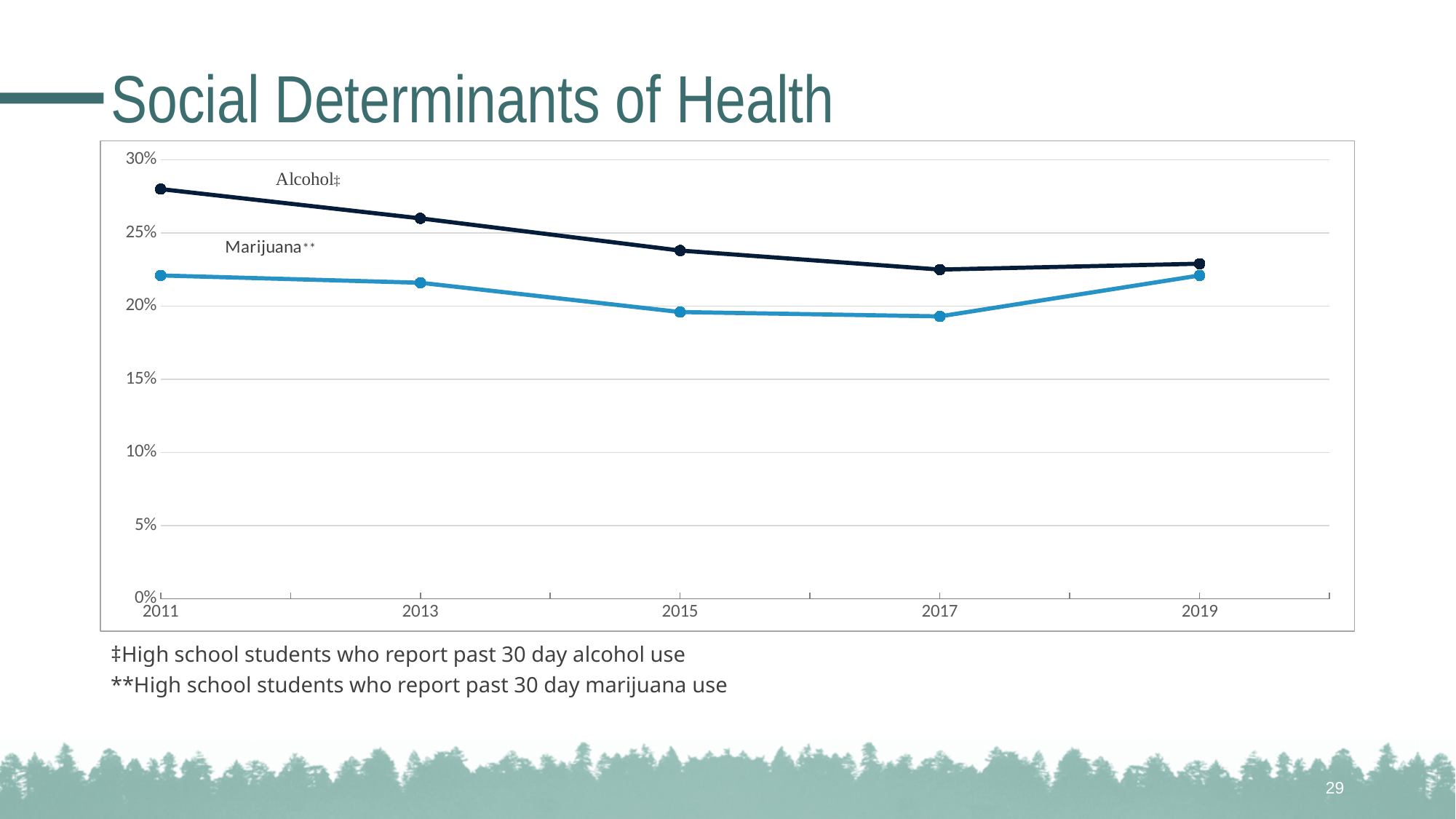
Is the Marijuana value for 2015 greater or less than 20%? less Is the Alcohol value for 2017 greater or less than 25%? less Does the Alcohol series rise or fall from 2011 to 2017? fall How many data series are plotted in the chart? 2 Does the Marijuana series rise or fall from 2017 to 2019? rise Is the Marijuana value for 2011 greater or less than 20%? greater What is the title of the slide containing the chart? Social Determinants of Health How many years are plotted along the x axis of the chart? 5 In 2015, which series has the higher value, Alcohol or Marijuana? Alcohol What kind of chart is shown on the slide? line chart In which year is the Alcohol series at its highest? 2011